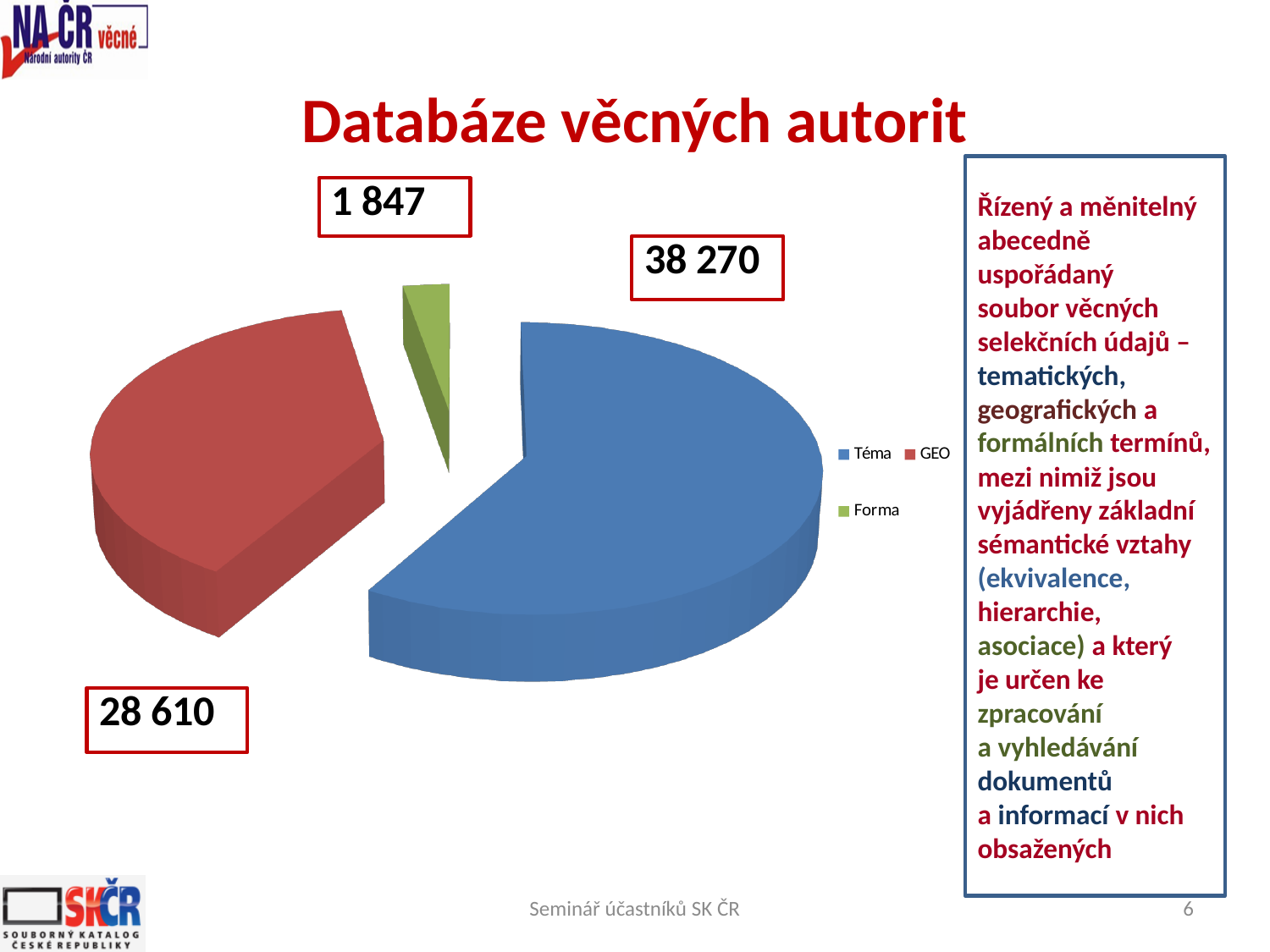
What is the value shown for Forma? 1 847 Which is larger, the value for GEO or the value for Forma? GEO What is the value shown for Téma? 38 270 What is the difference between the values for GEO and Forma? 26 763 What kind of chart is shown on the slide? pie chart What is the difference between the values for Téma and GEO? 9 660 Which category has the largest slice of the pie? Téma How many categories does the pie chart have? 3 What is the value shown for GEO? 28 610 What colour is the slice for GEO? red Which category has the smallest slice of the pie? Forma What is the total of all three values in the pie chart? 68 727